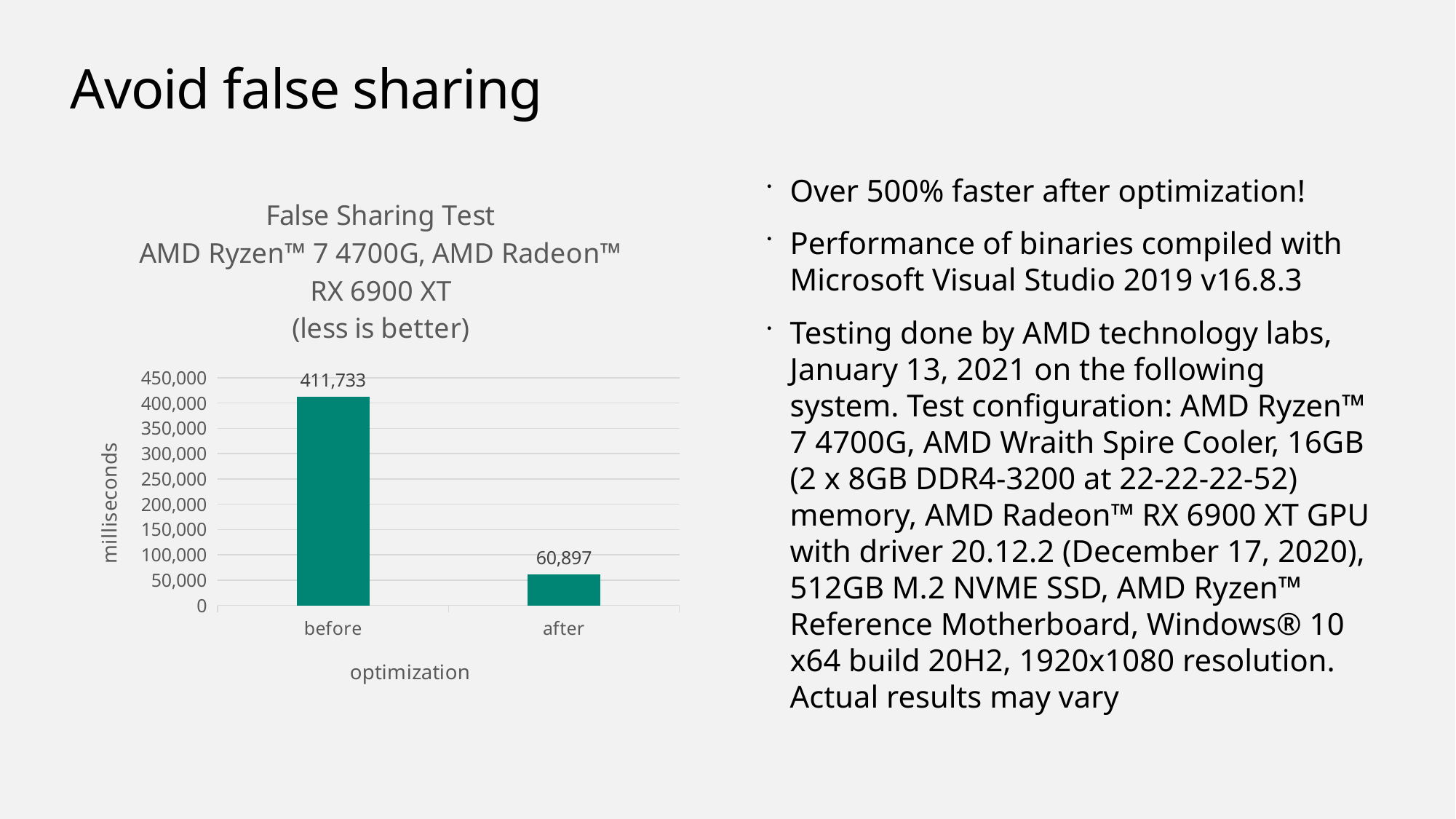
What is the label of the y axis? milliseconds Which category has the lowest value? after Is the value for "before" greater or less than 400,000? greater Is the value for "after" greater or less than 100,000? less Do the values rise or fall from "before" to "after"? fall What kind of chart is shown on the slide? bar chart What is the difference between the "before" and "after" values? 350,836 What is the value for "before" optimization? 411,733 Which is larger, the value for "before" or the value for "after"? before Which category has the highest value? before How many categories are shown on the x axis? 2 What is the value for "after" optimization? 60,897